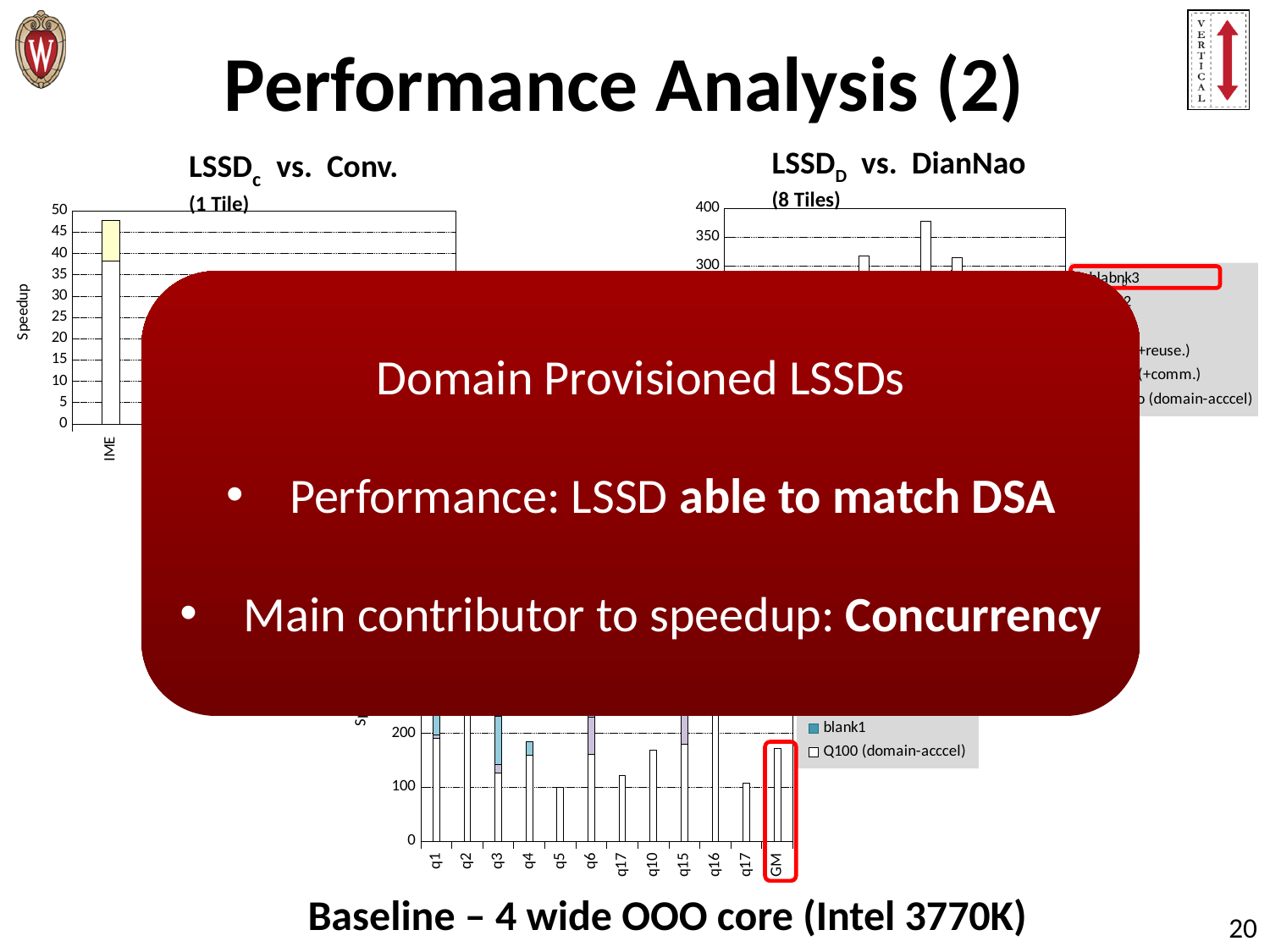
In the bottom chart, is the value for GM greater or less than 200? less In the bottom chart, how many categories are labelled on the x axis? 12 What is the y-axis label of the top-left chart (LSSDc vs. Conv.)? Speedup In the bottom chart, which category is outlined with a red box? GM In the top-left chart (LSSDc vs. Conv.), is the value for IME greater or less than 40? greater What kind of chart is the bottom chart on the slide? bar chart In the bottom chart, which is larger, the value for GM or the value for q5? GM What is the highest tick value shown on the y axis of the top-right chart (LSSDD vs. DianNao)? 400